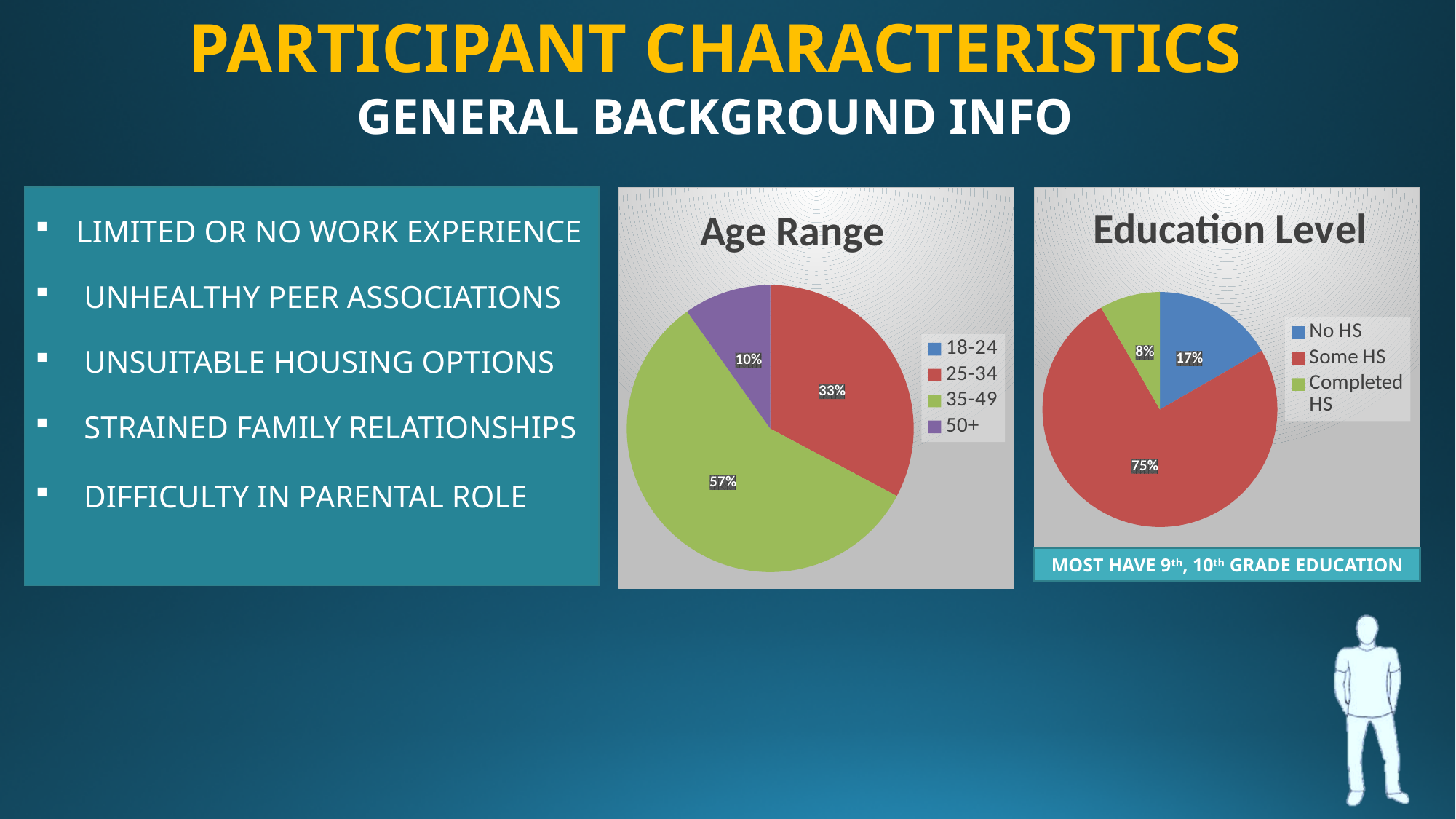
What type of chart is the Education Level chart? Pie chart In the Education Level chart, what percentage of participants have No HS? 17% In the Education Level chart, what percentage of participants Completed HS? 8% In the Age Range chart, which age group has the largest share? 35-49 In the Education Level chart, what percentage of participants have Some HS? 75% In the Age Range chart, what percentage of participants are aged 50+? 10% In the Age Range chart, how many age groups does the legend list? 4 In the Age Range chart, what percentage of participants are aged 35-49? 57% In the Education Level chart, which is larger: No HS or Completed HS? No HS In the Age Range chart, what percentage of participants are aged 25-34? 33% In the Education Level chart, which category has the smallest share? Completed HS In the Age Range chart, what is the difference between the 35-49 share and the 25-34 share? 24%